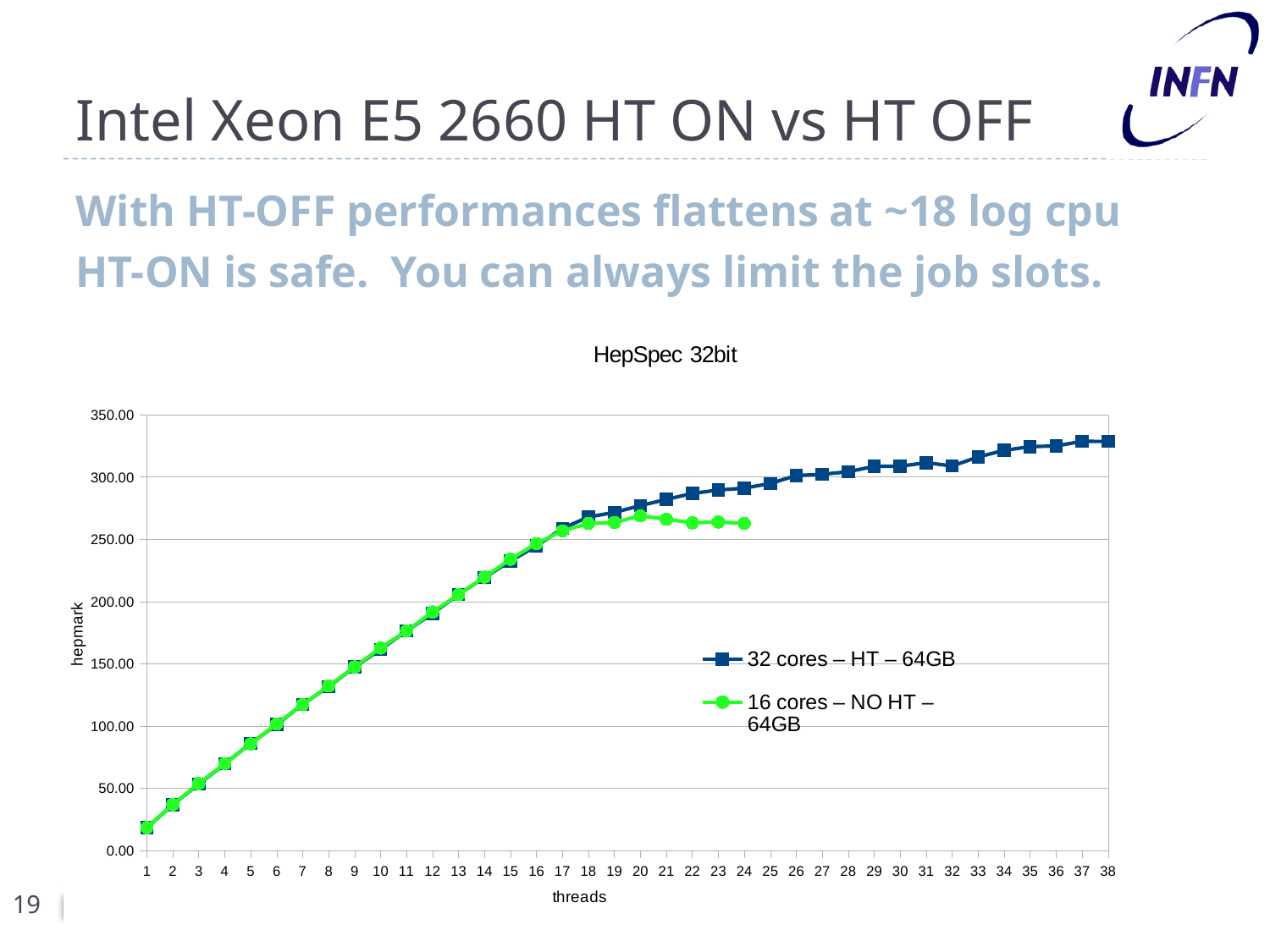
At 24 threads, which series has the larger value: '32 cores – HT – 64GB' or '16 cores – NO HT – 64GB'? 32 cores – HT – 64GB At how many thread values does the '16 cores – NO HT – 64GB' series have data points? 24 Is the value for '16 cores – NO HT – 64GB' at 10 threads greater or less than 150? greater How many series does the chart legend list? 2 What is the label of the y axis of the chart? hepmark What is the title of the chart? HepSpec 32bit Is the value for '16 cores – NO HT – 64GB' at 24 threads greater or less than 300? less What kind of chart is shown on the slide? line chart Does the '32 cores – HT – 64GB' series generally rise or fall as the number of threads increases? rise How many thread values are shown along the x axis of the chart? 38 Is the value for '32 cores – HT – 64GB' at 1 thread greater or less than 50? less